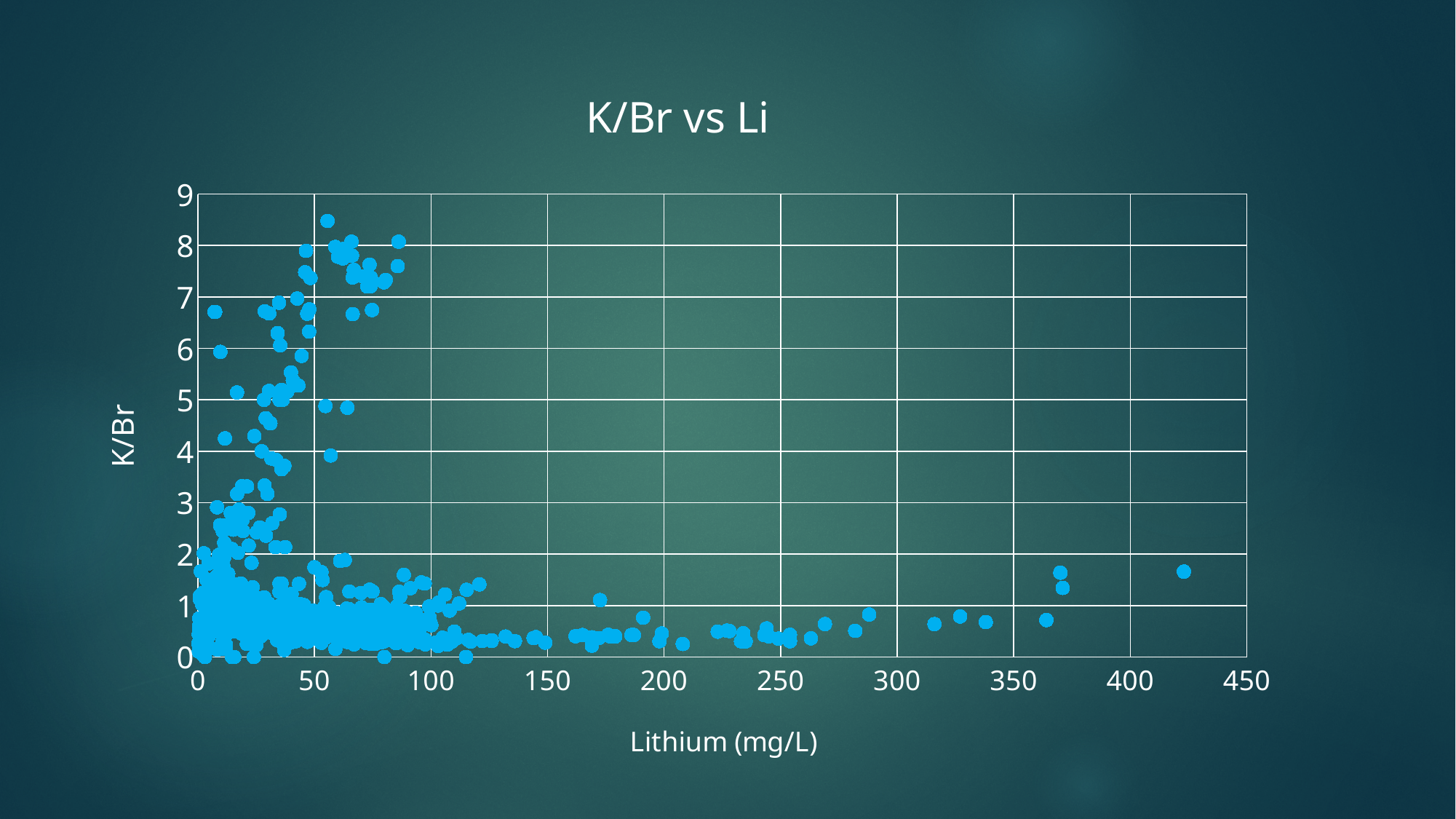
Are all points with lithium above 300 mg/L at K/Br values greater or less than 2? less What is the title of the chart? K/Br vs Li Is the highest K/Br value plotted greater or less than 8? greater Is the highest K/Br value plotted greater or less than 9? less Are the points with K/Br above 5 found at lithium values below 100 or above 100? below 100 What kind of chart is shown on the slide? scatter plot What is the label of the x axis? Lithium (mg/L)